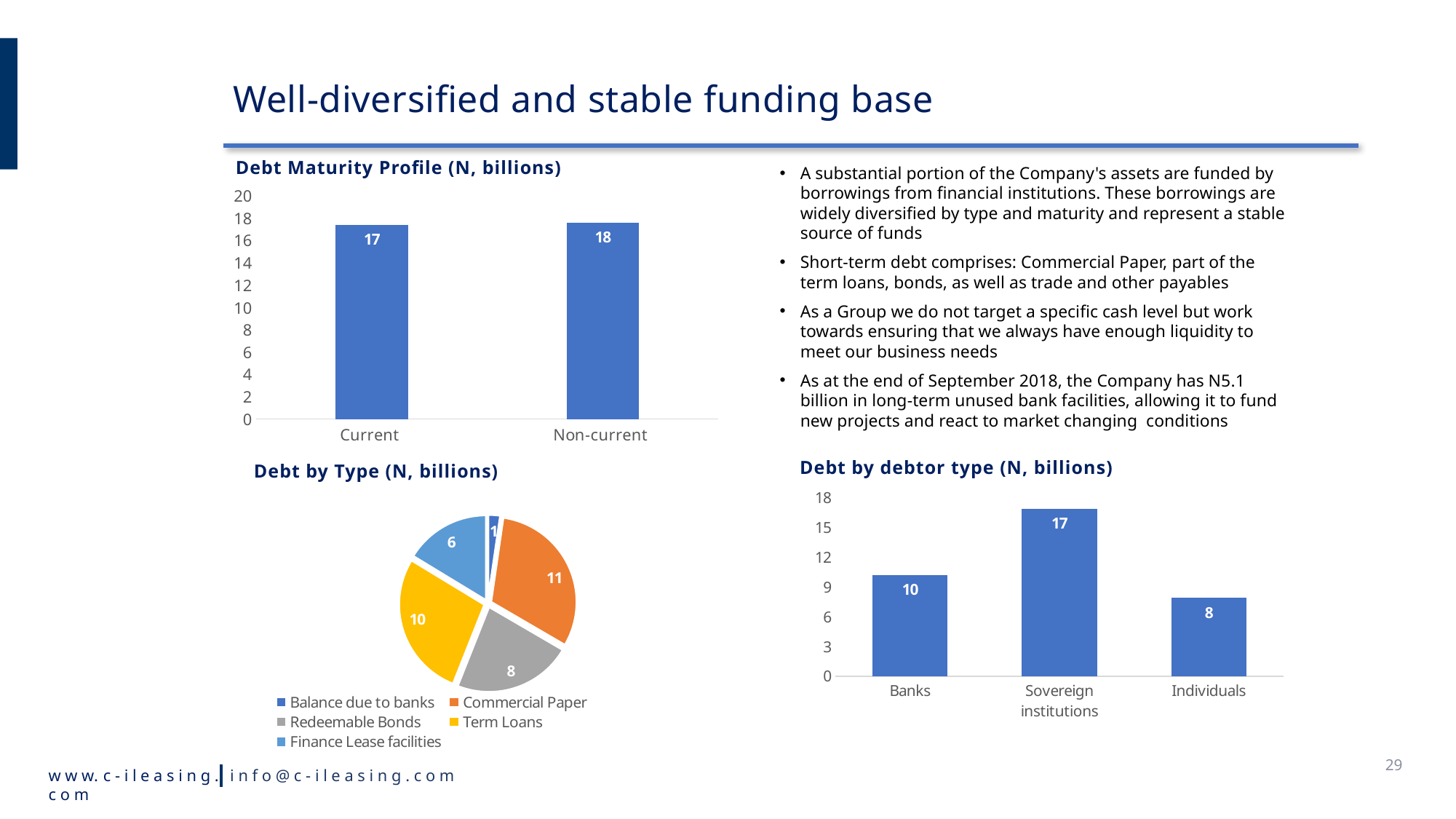
What kind of chart is the Debt by Type chart? Pie chart In the Debt Maturity Profile chart, what is the value for Current? 17 In the Debt by debtor type chart, what is the value for Sovereign institutions? 17 In the Debt by Type pie chart, which is larger: Term Loans or Redeemable Bonds? Term Loans In the Debt by debtor type chart, which category has the lowest value? Individuals In the Debt by debtor type chart, what is the difference between Banks and Individuals? 2 In the Debt by Type pie chart, which category has the smallest value? Balance due to banks In the Debt Maturity Profile chart, what is the value for Non-current? 18 In the Debt by Type pie chart, which category has the largest value? Commercial Paper How many categories does the legend of the Debt by Type pie chart list? 5 In the Debt Maturity Profile chart, what is the difference between the Non-current and Current values? 1 In the Debt by Type pie chart, what is the value for Commercial Paper? 11